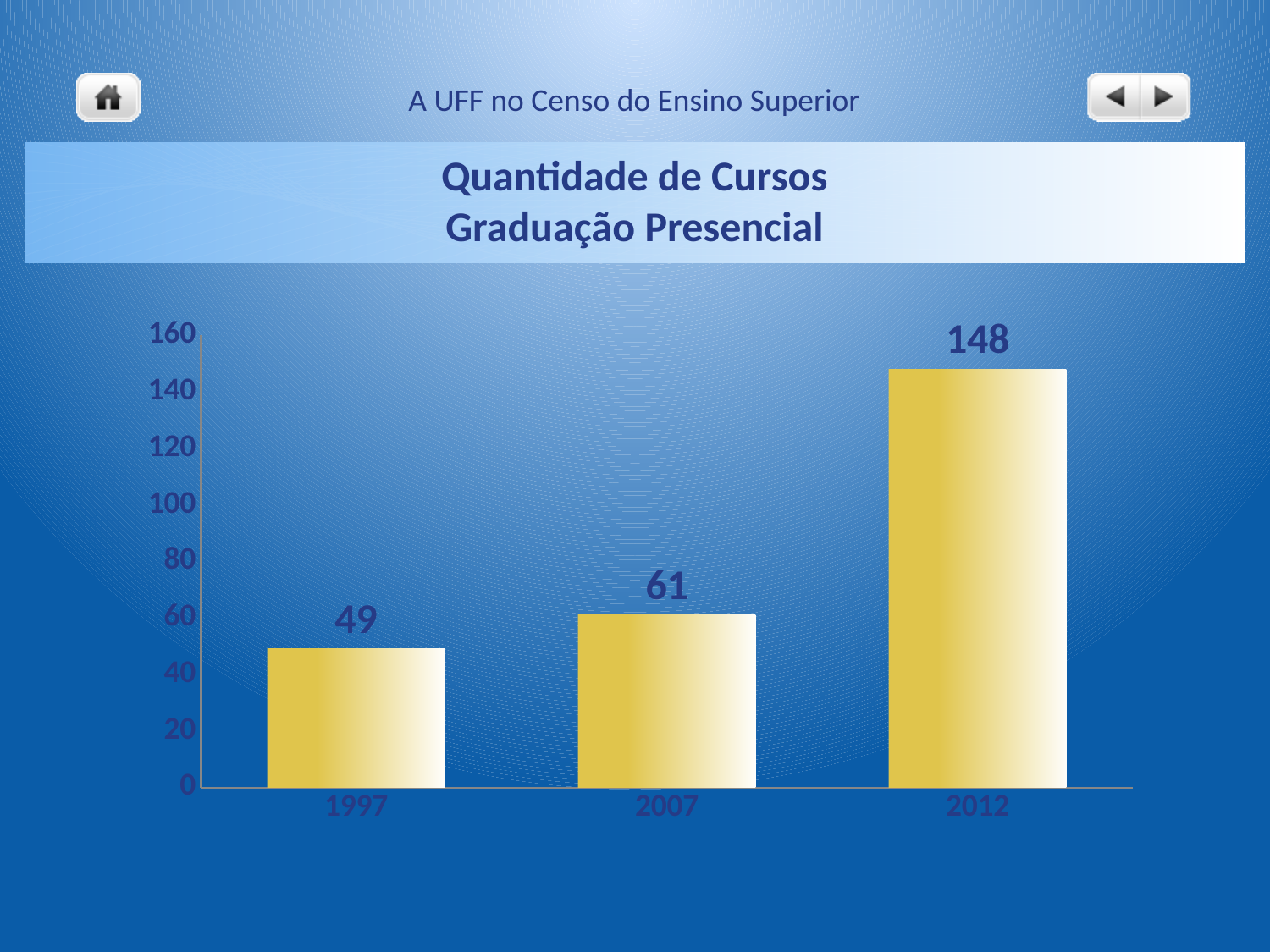
Which year has the lowest value? 1997 What is the value for 1997? 49 What is the value for 2012? 148 Which is larger, the value for 1997 or the value for 2007? 2007 Which year has the highest value? 2012 What is the difference between the values for 2012 and 2007? 87 What is the value for 2007? 61 Do the values rise or fall from 1997 to 2012? rise What is the difference between the values for 2007 and 1997? 12 Is the value for 2012 greater or less than 140? greater What kind of chart is shown on the slide? bar chart How many years are shown on the x axis? 3